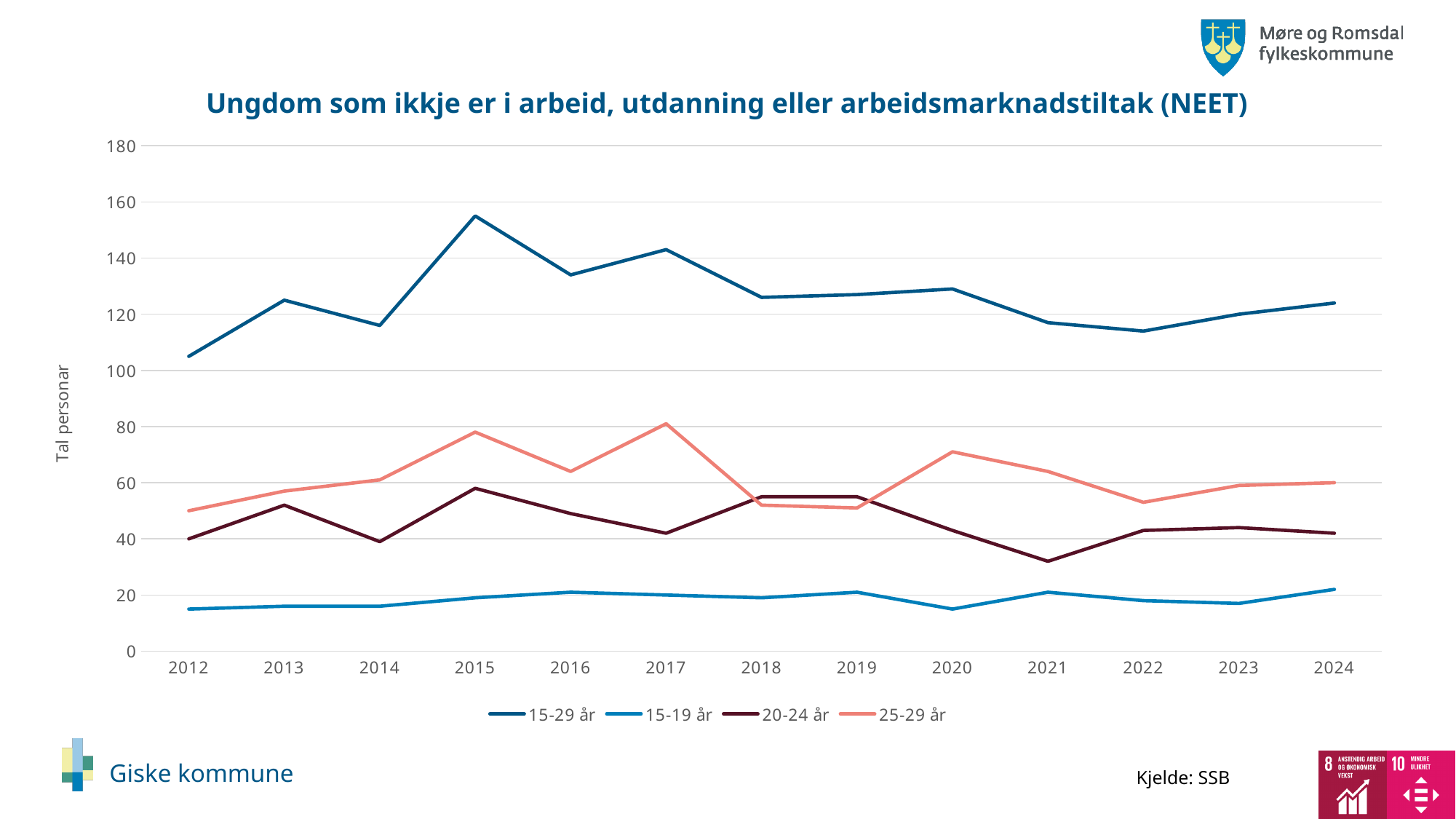
How many years are shown along the x axis? 13 Is the value for 15-29 år in 2012 greater or less than 120? less In 2017, which series has the higher value: 20-24 år or 25-29 år? 25-29 år How many series does the legend list? 4 In which year does the 15-29 år series reach its highest value? 2015 Is the value for 15-29 år in 2015 greater or less than 140? greater Does the 15-29 år series rise or fall from 2020 to 2022? fall In which year does the 15-29 år series have its lowest value? 2012 Is the value for 25-29 år in 2020 greater or less than 60? greater In which year does the 20-24 år series have its lowest value? 2021 What kind of chart is shown on the slide? line chart